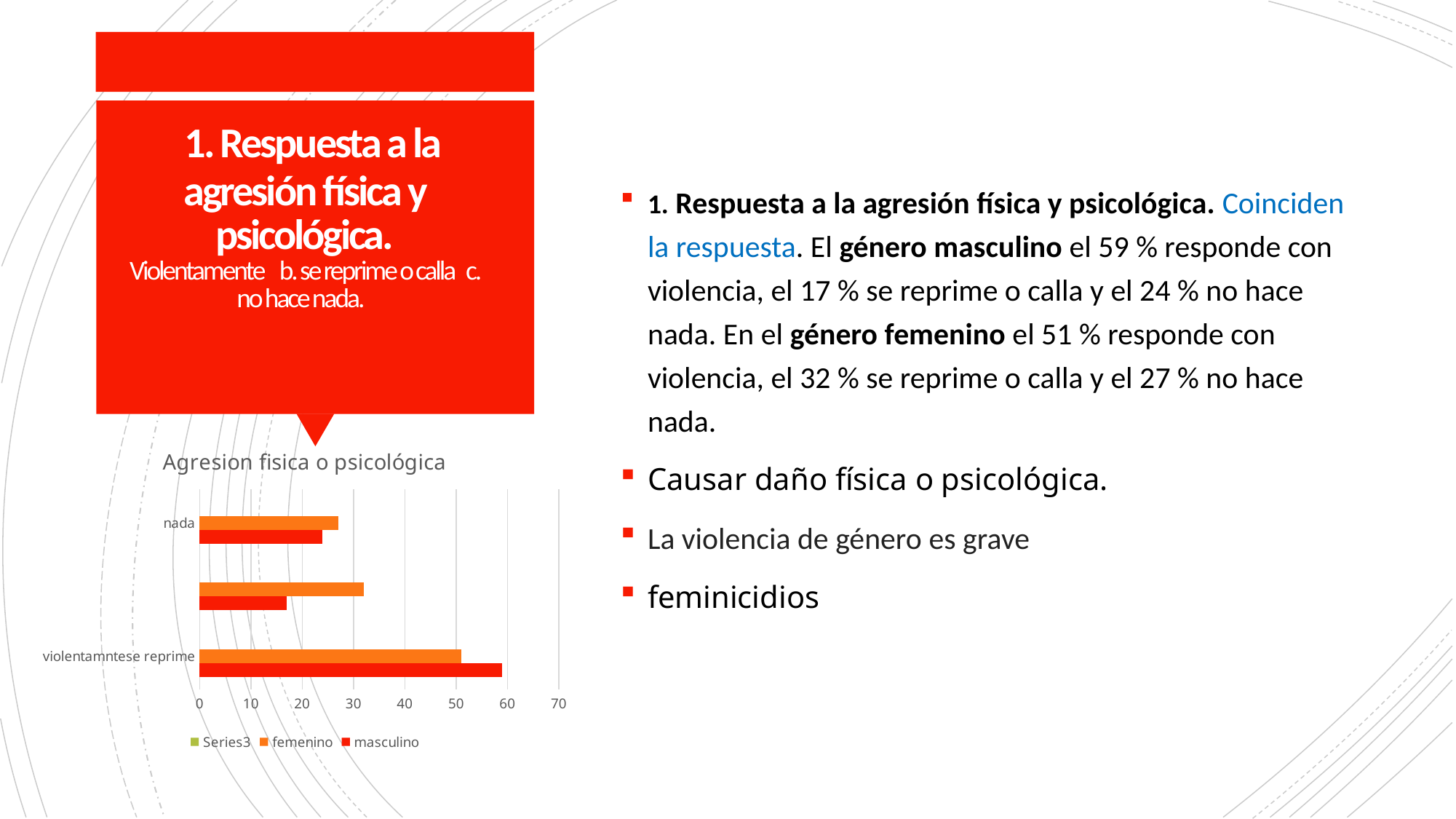
What kind of chart is shown on the slide? bar chart What is the highest value shown on the chart's horizontal axis? 70 Is the masculino value for the 'nada' category greater or less than 30? less How many category groups of bars are plotted in the chart? 3 Which series are listed in the chart legend? Series3, femenino, masculino What is the title of the chart on the slide? Agresion fisica o psicológica For the 'nada' category, which series has the larger value, femenino or masculino? femenino Which series has the longest bar in the chart? masculino Is the longest masculino bar in the chart greater or less than 50? greater How many series does the chart legend list? 3 Is the femenino value for the 'nada' category greater or less than 20? greater